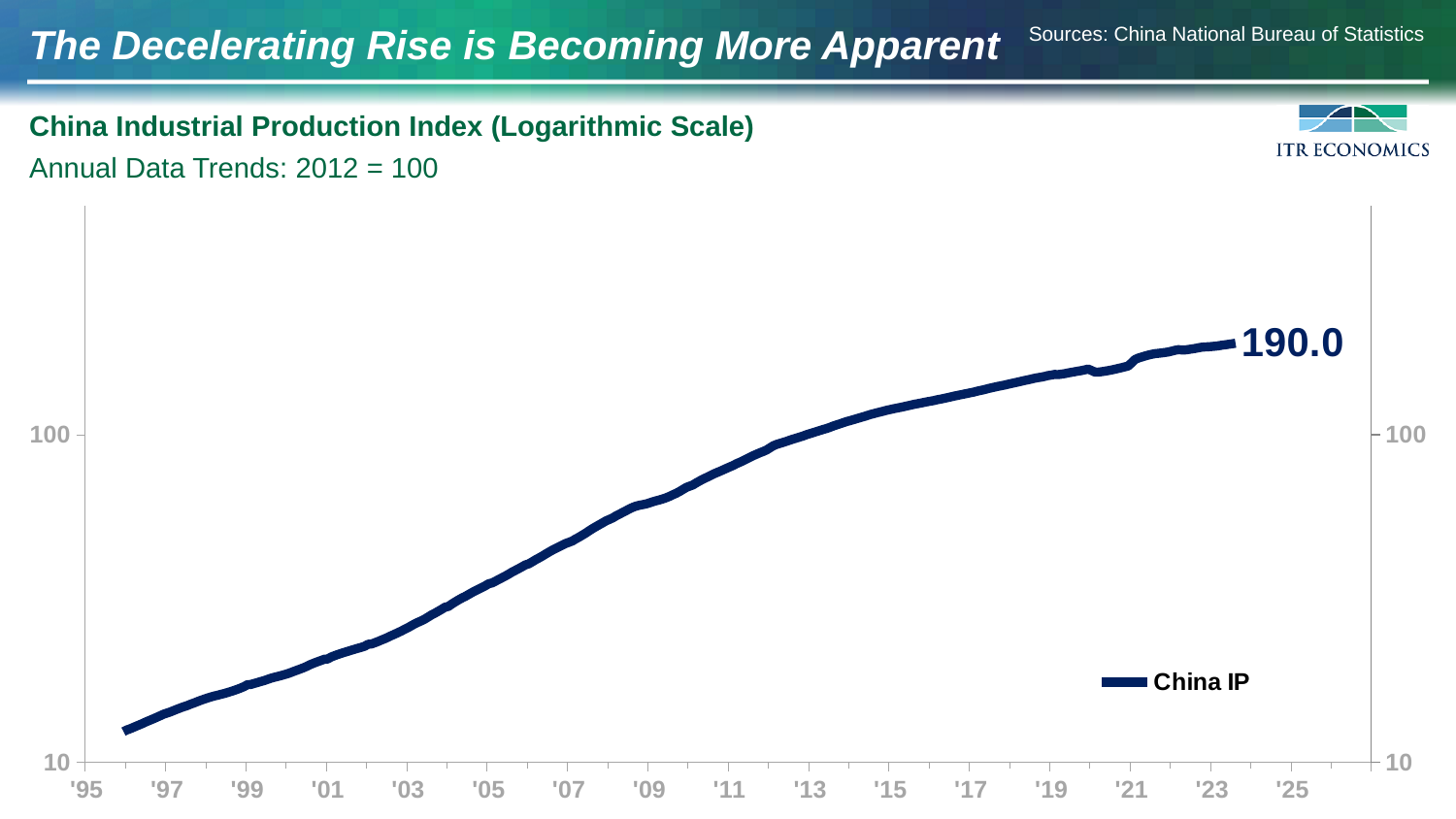
What is the highest value reached by the China IP line? 190.0 Is the value of China IP in '15 greater or less than 100? greater What is the value printed at the end of the China IP line? 190.0 Is the value of China IP in '97 greater or less than 10? greater Which is larger, the China IP value in '01 or in '21? '21 What is the title of the chart? China Industrial Production Index (Logarithmic Scale) How many series does the legend list? 1 Does the China IP line generally rise or fall from '95 to '23? rise Is the value of China IP in '11 greater or less than 100? less What is the name of the series shown in the legend? China IP What type of chart is shown on the slide? line chart